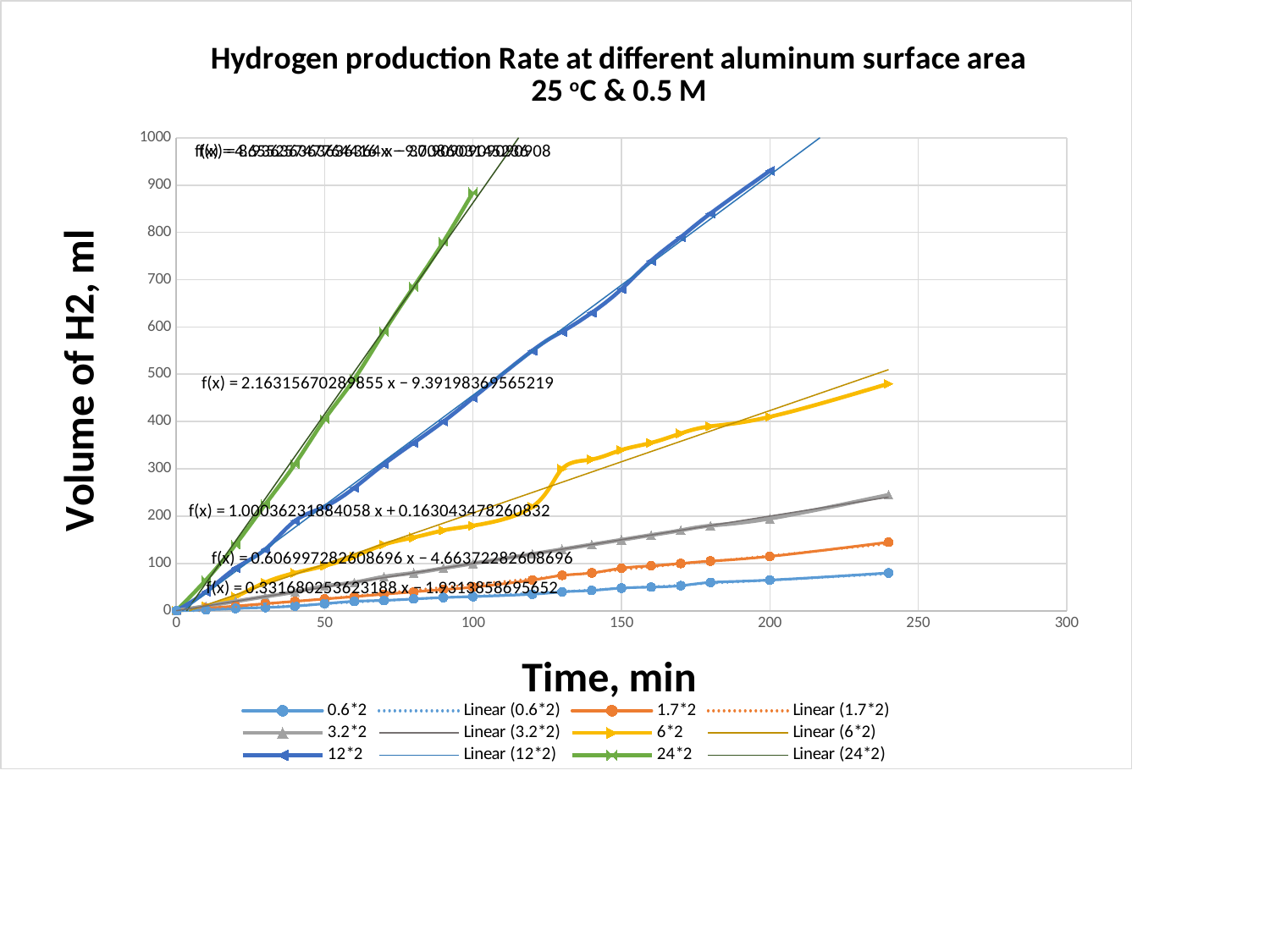
Among the series plotted out to 240 min, which one reaches the highest volume at 240 min? 6*2 At 100 min, which series has the larger volume, 24*2 or 12*2? 24*2 How many of the legend entries are 'Linear' trendlines? 6 Among the series plotted out to 240 min, which one has the lowest volume at 240 min? 0.6*2 Is the value for the 24*2 series at 100 min greater or less than 800? greater How many entries does the chart legend list? 12 Is the value for the 0.6*2 series at 240 min greater or less than 100? less Is the value for the 6*2 series at 240 min greater or less than 400? greater What is the title of the chart? Hydrogen production Rate at different aluminum surface area 25 °C & 0.5 M What kind of chart is shown on the slide? line chart Do the values of the 12*2 series rise or fall as time increases? rise What is the label of the vertical axis? Volume of H2, ml